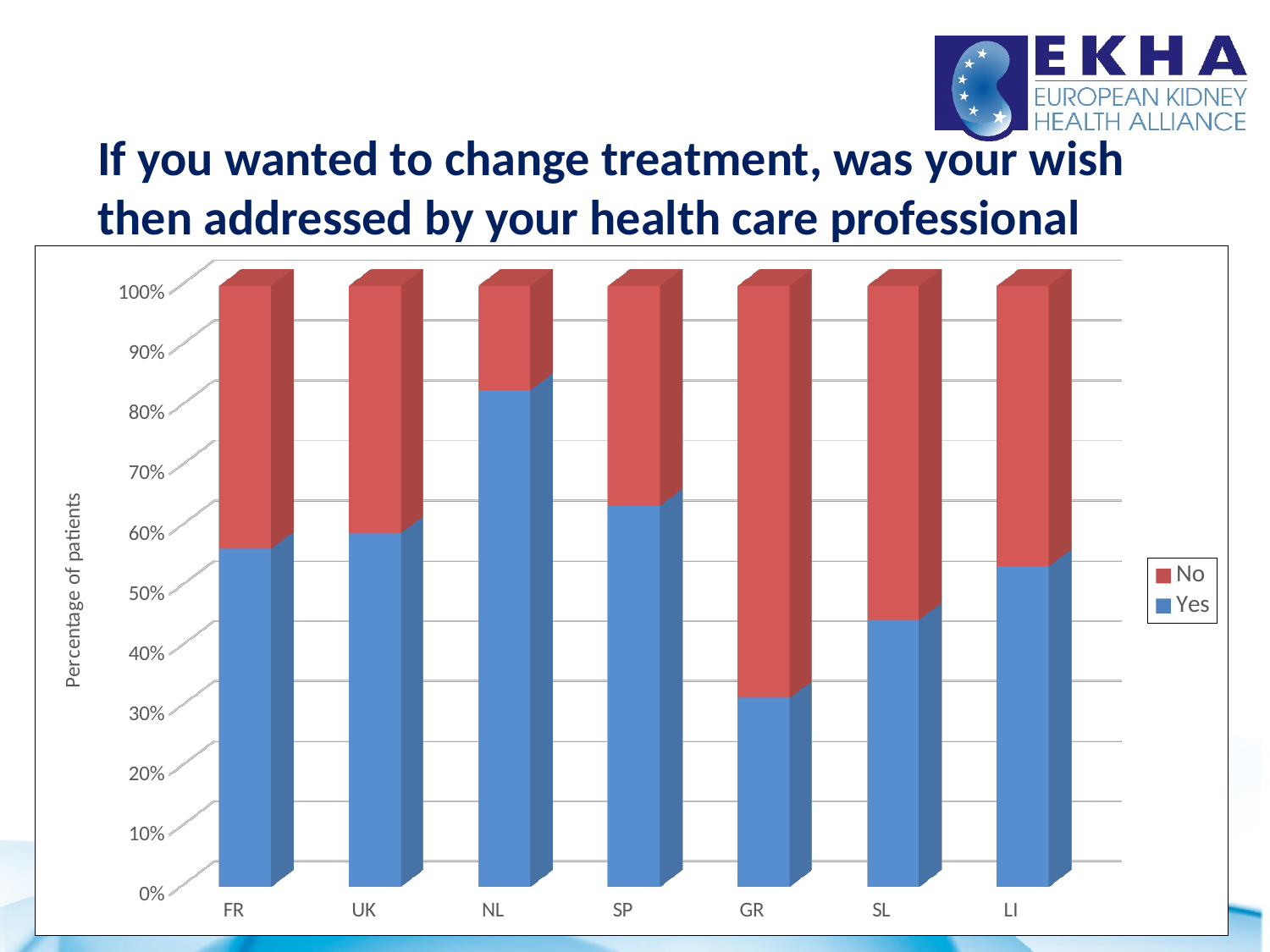
Which country has the highest share of 'Yes' responses? NL What is the total of the stacked bar for FR? 100% What kind of chart is shown on the slide? Stacked bar chart Is the 'Yes' value for NL greater or less than 80%? greater Is the 'Yes' value for SL greater or less than 50%? less What is the label on the vertical axis of the chart? Percentage of patients Is the 'Yes' value for GR greater or less than 40%? less How many countries are shown on the x axis of the chart? 7 How many series does the legend list? 2 Which has a larger 'No' share, GR or NL? GR Which country has the lowest share of 'Yes' responses? GR